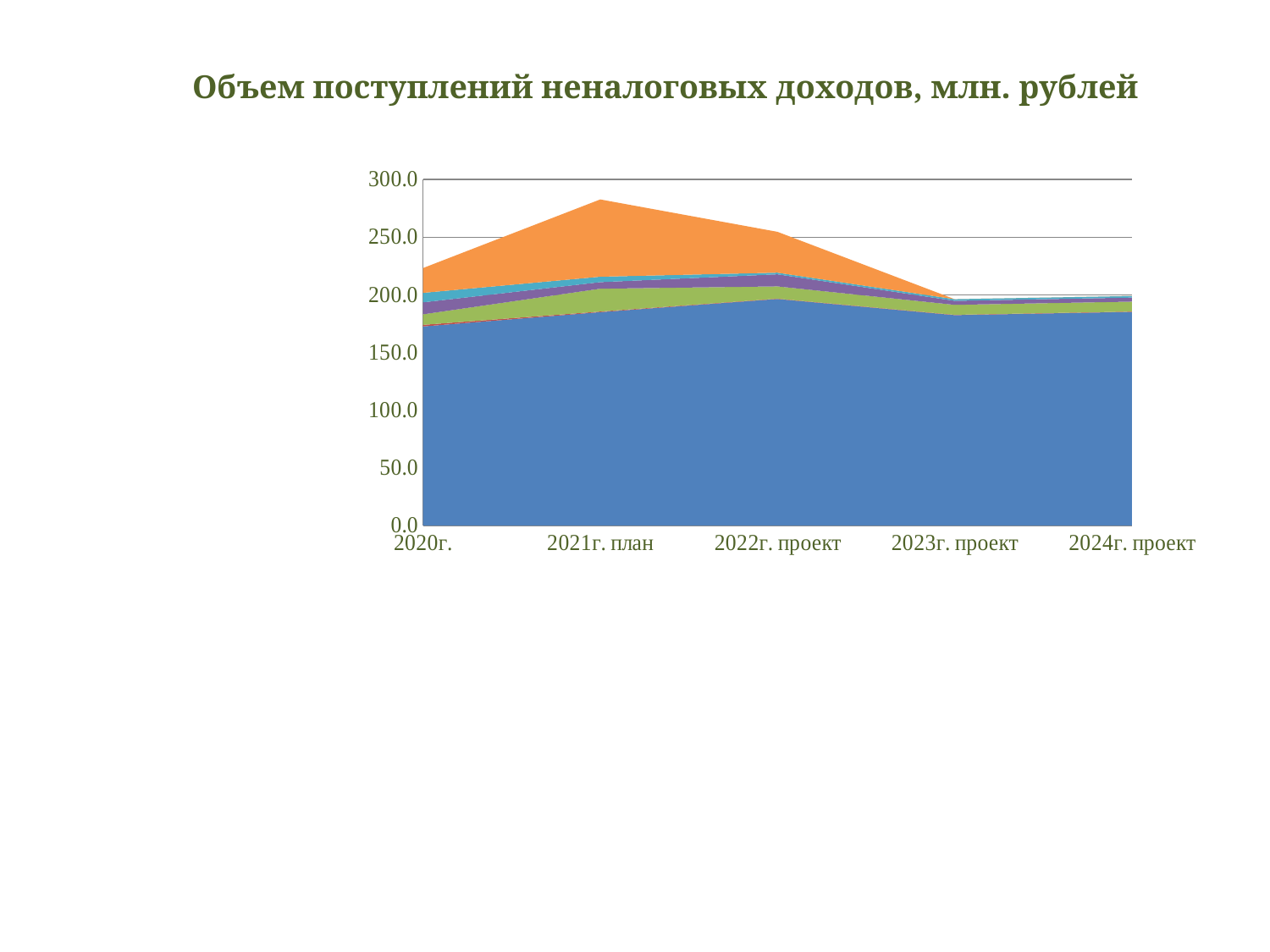
Is the total stacked value for 2021г. план greater or less than 250? greater Which has the larger total stacked value, 2021г. план or 2023г. проект? 2021г. план Is the value of the bottom (blue) series for 2020г. greater or less than 200? less Do the total stacked values rise or fall from 2021г. план to 2024г. проект? fall How many categories are shown along the x axis? 5 Which category has the highest total stacked value? 2021г. план Is the total stacked value for 2023г. проект greater or less than 250? less What is the title of the chart? Объем поступлений неналоговых доходов, млн. рублей What kind of chart is shown on the slide? Area chart